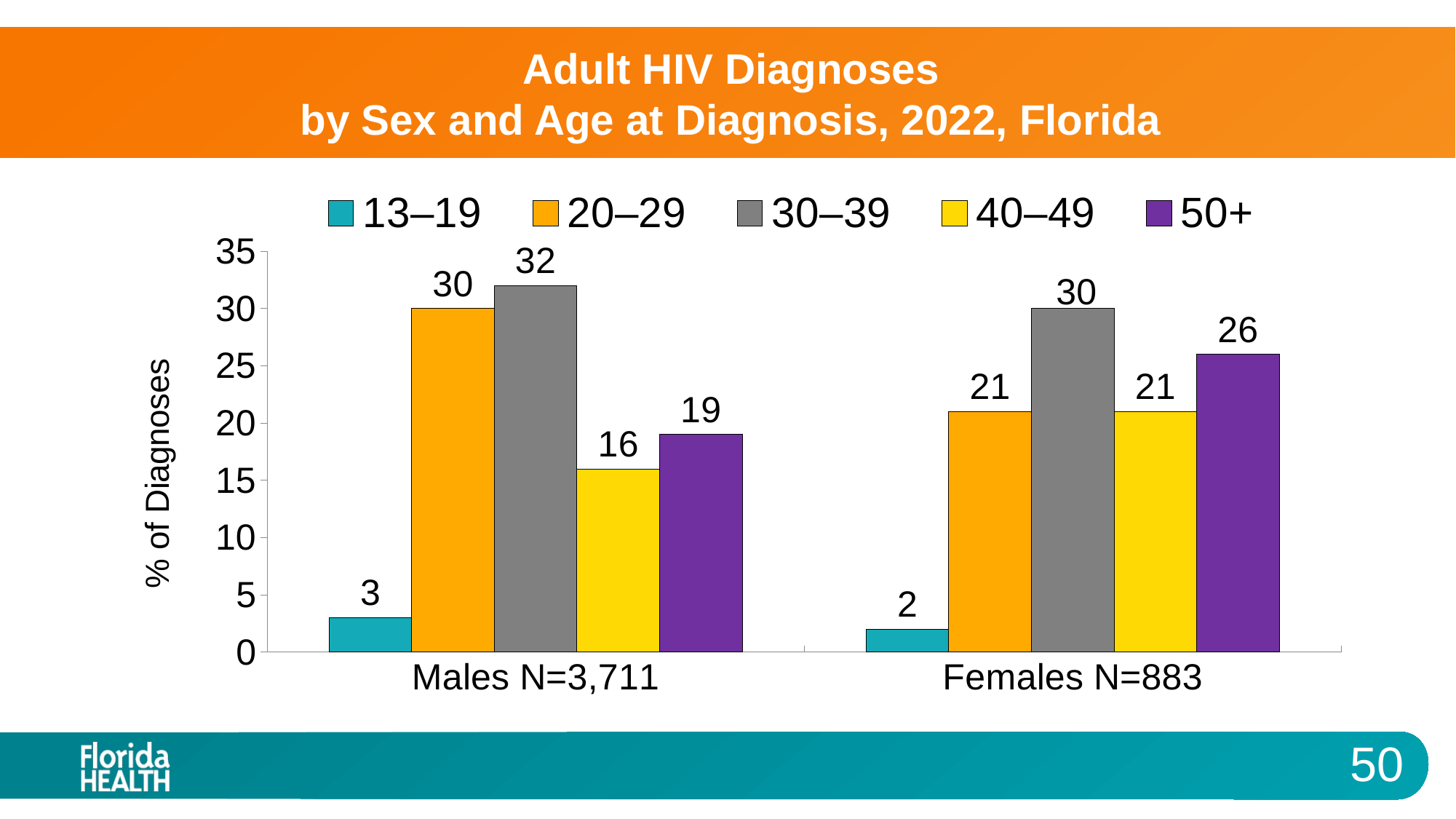
How many age groups does the legend list? 5 What kind of chart is shown on the slide? Bar chart What percentage of male HIV diagnoses were in the 30–39 age group? 32 How many categories are shown on the x axis? 2 Which age group has the highest percentage of diagnoses among females? 30–39 What is the label of the y axis? % of Diagnoses Which age group has the lowest percentage of diagnoses among males? 13–19 What is the N value shown for females? 883 What percentage of male HIV diagnoses were in the 13–19 age group? 3 What percentage of female HIV diagnoses were in the 50+ age group? 26 Which is larger: the 20–29 percentage for males or the 20–29 percentage for females? Males What is the difference between the 50+ percentage for females and the 50+ percentage for males? 7